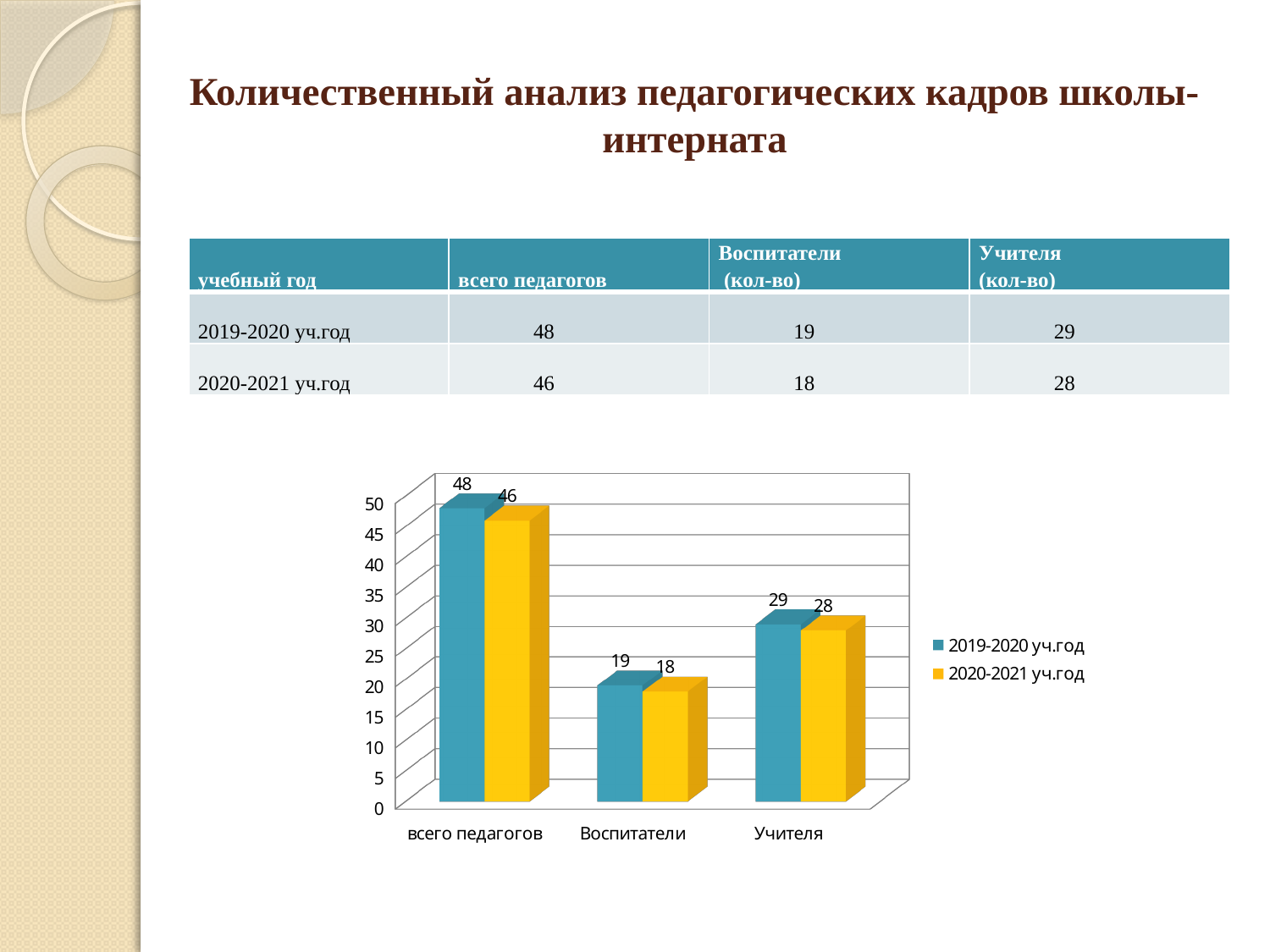
What is the value for Учителя in the 2019-2020 уч.год series? 29 What is the difference between the Учителя and Воспитатели values in the 2020-2021 уч.год series? 10 Which category has the lowest value in the 2019-2020 уч.год series? Воспитатели What is the value for всего педагогов in the 2019-2020 уч.год series? 48 How many series does the legend list? 2 Which is larger: the 2019-2020 уч.год value for Учителя or the 2020-2021 уч.год value for Учителя? 2019-2020 уч.год What is the difference between the 2019-2020 уч.год and 2020-2021 уч.год values for всего педагогов? 2 Which colour represents the 2020-2021 уч.год series in the chart? yellow How many categories are shown on the x axis of the chart? 3 What kind of chart is shown on the slide? bar chart What is the value for Воспитатели in the 2020-2021 уч.год series? 18 Which category has the highest value in the 2020-2021 уч.год series? всего педагогов